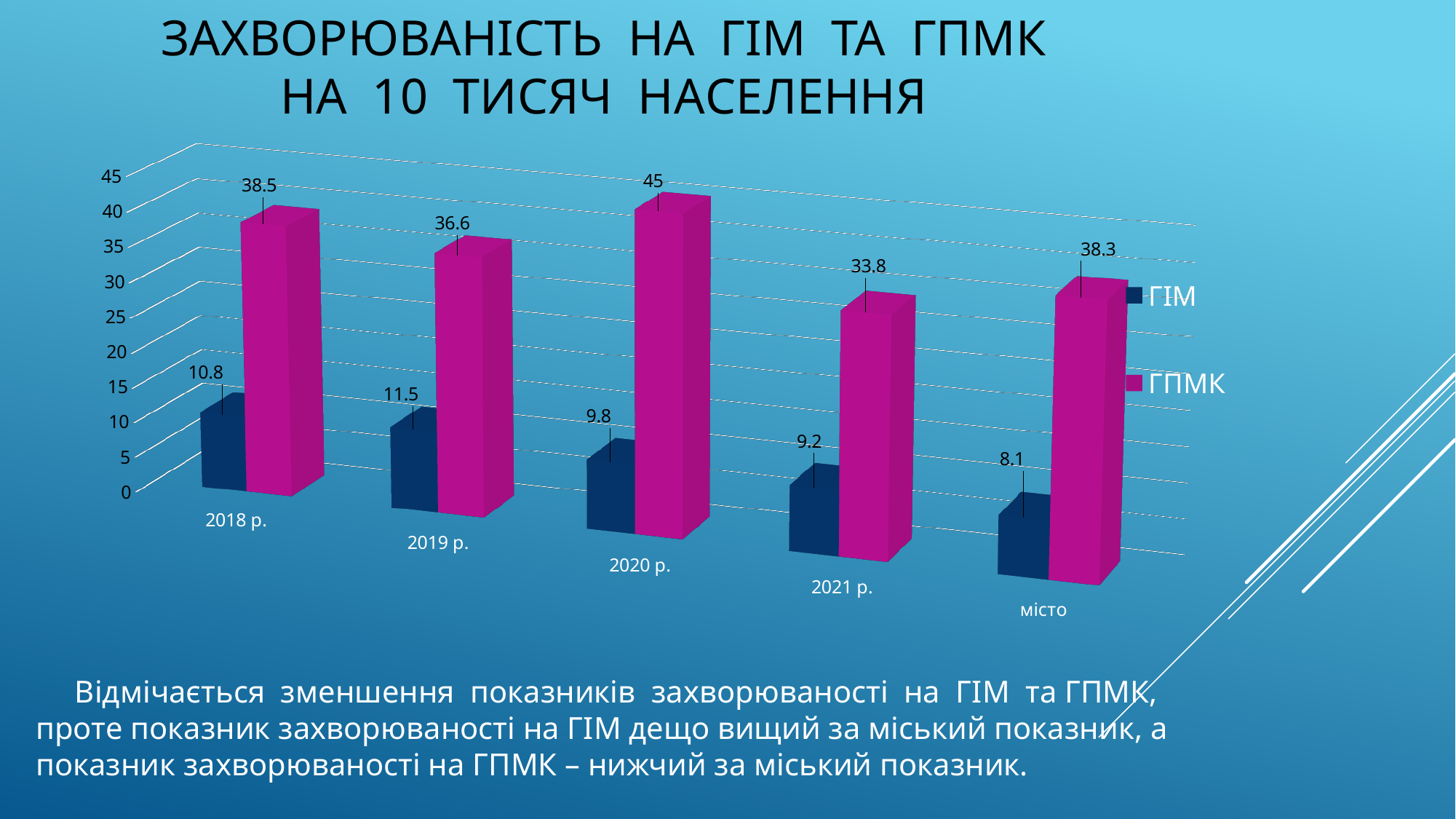
What kind of chart is shown on the slide? bar chart What is the difference between the ГПМК values for 2018 р. and 2021 р.? 4.7 Which category has the lowest ГПМК value? 2021 р. How many series does the legend list? 2 Which series is shown in magenta? ГПМК Which category has the lowest ГІМ value? місто Which is larger, the ГІМ value for 2018 р. or for 2019 р.? 2019 р. What is the ГПМК value for місто? 38.3 What is the ГІМ value for 2019 р.? 11.5 Which category has the highest ГПМК value? 2020 р. What is the ГПМК value for 2020 р.? 45 How many categories are shown on the x axis? 5